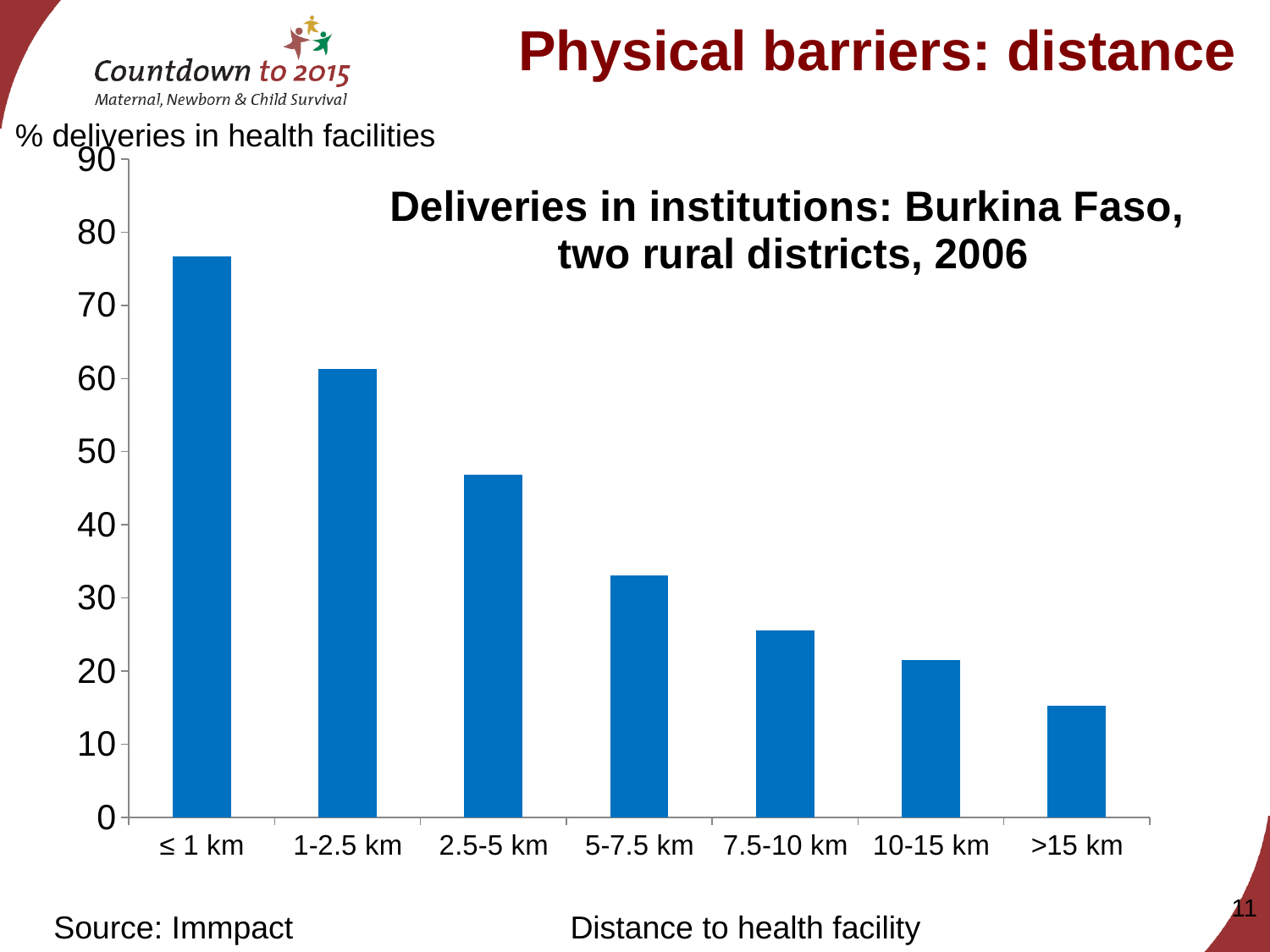
What kind of chart is shown on the slide? Bar chart How many distance categories are shown on the x axis? 7 Which distance category has the lowest percentage of deliveries in health facilities? >15 km What is the title of the chart? Deliveries in institutions: Burkina Faso, two rural districts, 2006 Which distance category has the highest percentage of deliveries in health facilities? ≤ 1 km Is the value for 2.5-5 km greater or less than 50? less Which is larger, the value for 5-7.5 km or the value for 10-15 km? 5-7.5 km Do the values rise or fall as distance to the health facility increases along the x axis? Fall Is the value for >15 km greater or less than 20? less Is the value for ≤ 1 km greater or less than 70? greater What is the label of the x axis? Distance to health facility